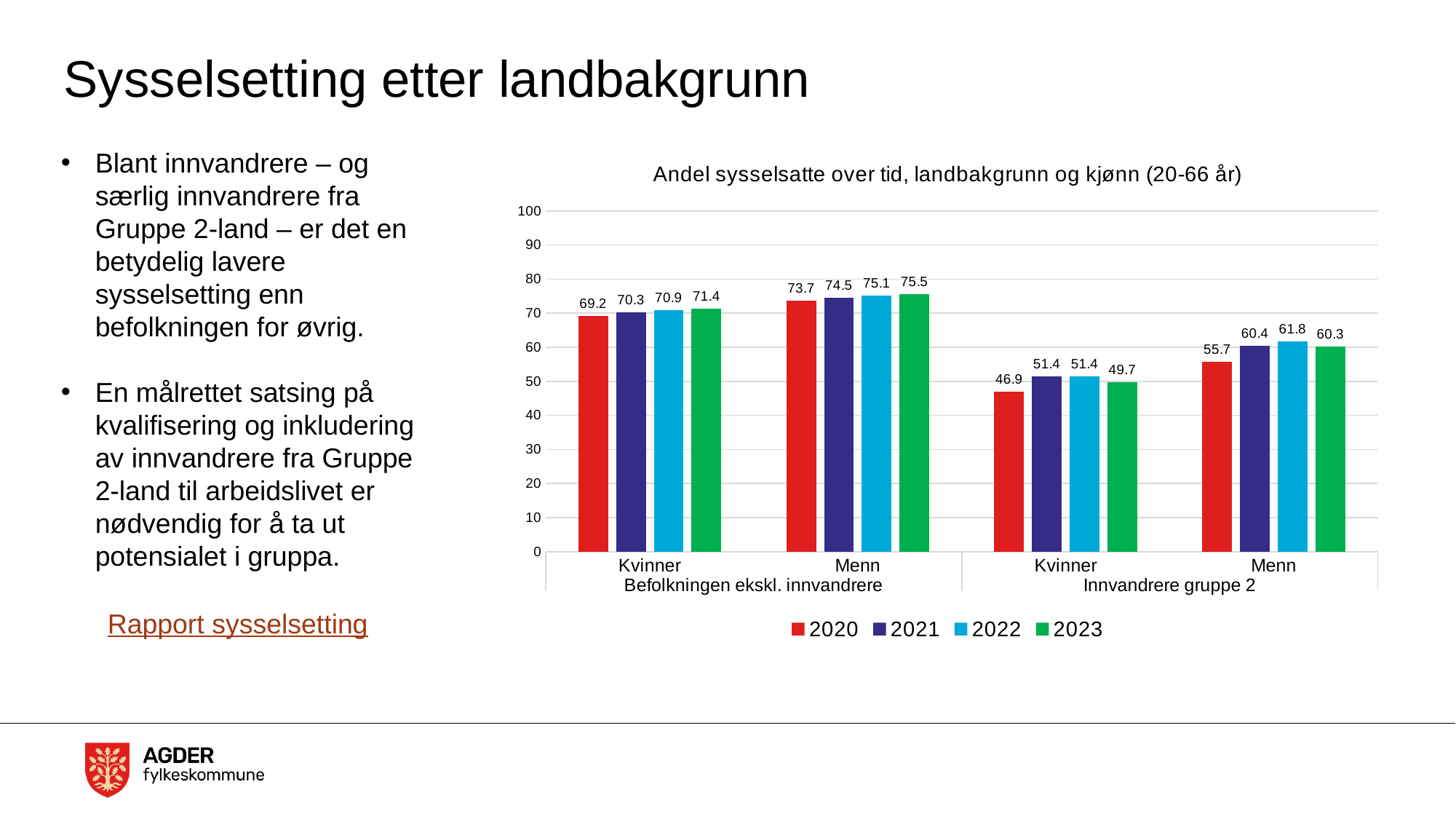
What is the 2023 value for Menn in Befolkningen ekskl. innvandrere? 75.5 What is the title of the chart? Andel sysselsatte over tid, landbakgrunn og kjønn (20-66 år) What kind of chart is shown on the slide? bar chart Is the 2020 value for Menn in Innvandrere gruppe 2 greater or less than 60? less Which is larger: the 2021 value for Kvinner in Innvandrere gruppe 2 or the 2023 value for Kvinner in Innvandrere gruppe 2? 2021 What is the difference between the 2023 and 2020 values for Kvinner in Befolkningen ekskl. innvandrere? 2.2 Which year has the highest value for Menn in Innvandrere gruppe 2? 2022 Which year has the lowest value for Kvinner in Innvandrere gruppe 2? 2020 Do the values for Menn in Befolkningen ekskl. innvandrere rise or fall from 2020 to 2023? rise How many series does the legend list? 4 What is the 2020 value for Kvinner in Innvandrere gruppe 2? 46.9 What is the 2022 value for Menn in Innvandrere gruppe 2? 61.8